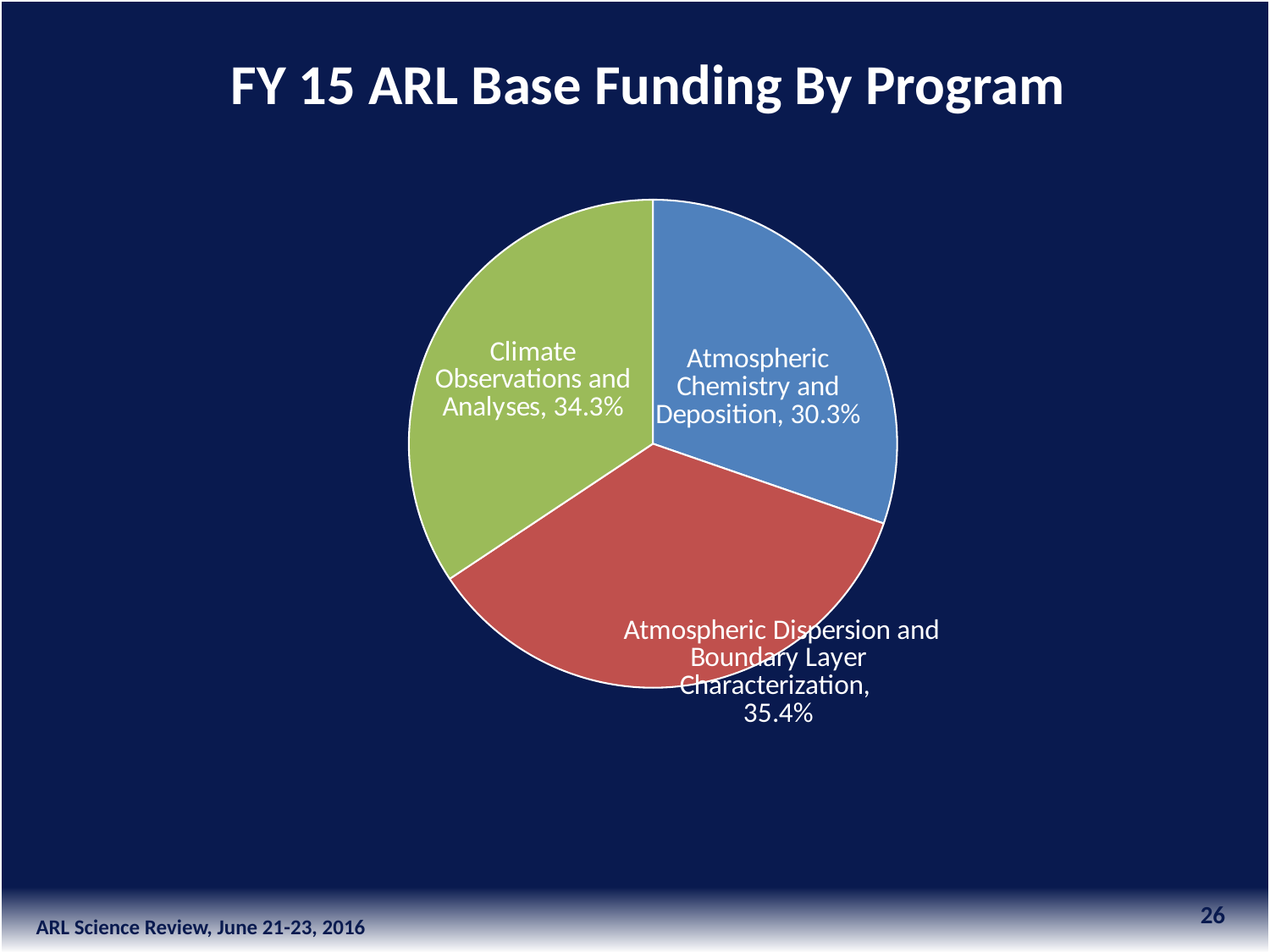
What colour is the slice for Atmospheric Dispersion and Boundary Layer Characterization? Red What is the difference in percentage points between the Atmospheric Dispersion and Boundary Layer Characterization share and the Climate Observations and Analyses share? 1.1 percentage points What is the difference in percentage points between the Climate Observations and Analyses share and the Atmospheric Chemistry and Deposition share? 4.0 percentage points Which share is larger: Climate Observations and Analyses or Atmospheric Chemistry and Deposition? Climate Observations and Analyses What is the title of the chart? FY 15 ARL Base Funding By Program How many programs are shown in the pie chart? 3 What share of FY 15 ARL base funding goes to Atmospheric Dispersion and Boundary Layer Characterization? 35.4% Which program receives the largest share of FY 15 ARL base funding? Atmospheric Dispersion and Boundary Layer Characterization What share of FY 15 ARL base funding goes to Atmospheric Chemistry and Deposition? 30.3% What kind of chart is shown on the slide? Pie chart What share of FY 15 ARL base funding goes to Climate Observations and Analyses? 34.3% Which program receives the smallest share of FY 15 ARL base funding? Atmospheric Chemistry and Deposition